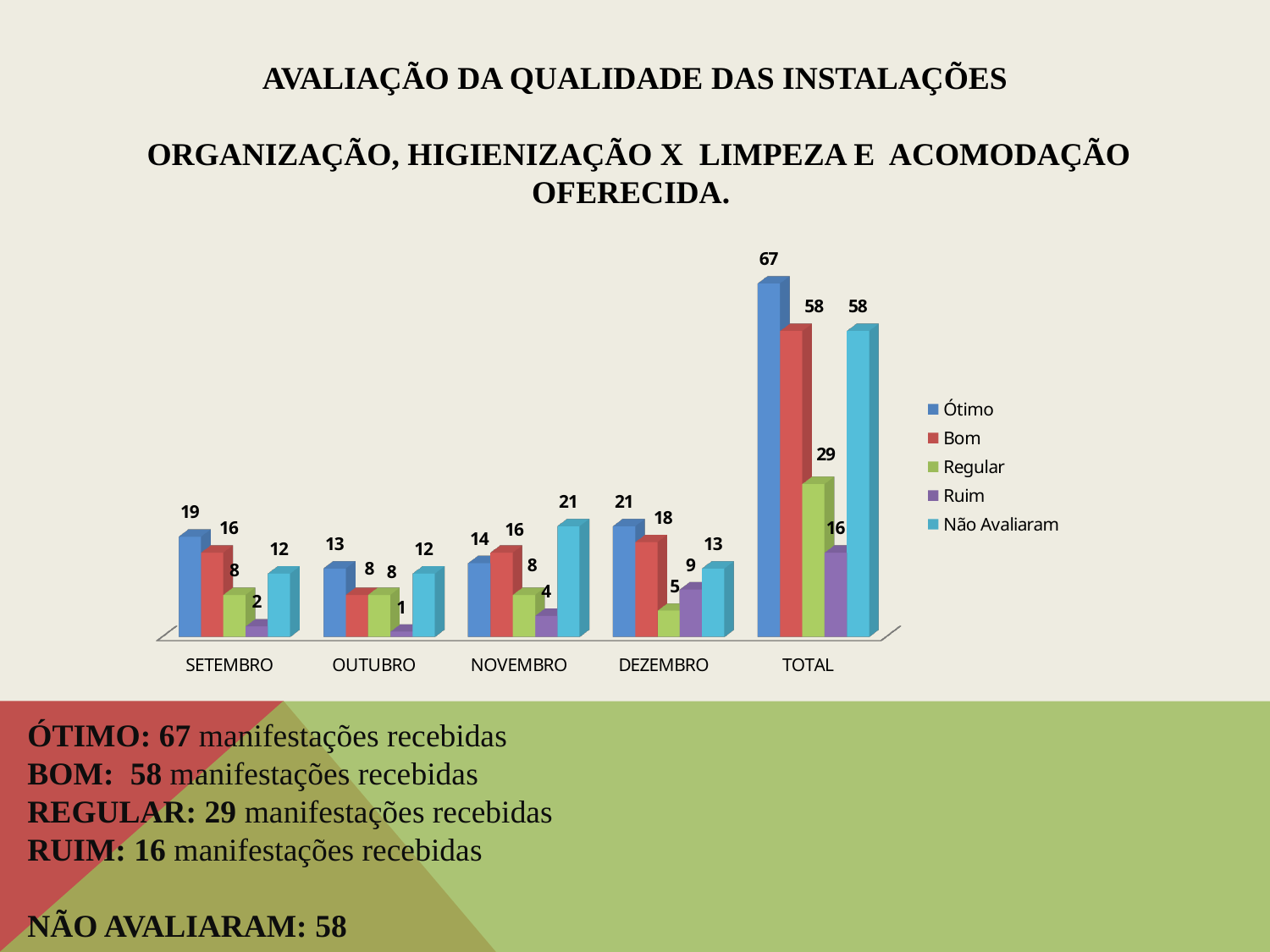
Which category has the highest value for Ótimo? TOTAL How many series does the legend list? 5 Which is larger in DEZEMBRO, Ótimo or Bom? Ótimo What is the value for Ruim in OUTUBRO? 1 What kind of chart is shown on the slide? Bar chart What is the value for Não Avaliaram in NOVEMBRO? 21 Excluding TOTAL, which month has the lowest value for Ruim? OUTUBRO Which series is shown in red in the legend? Bom What is the value for Regular in TOTAL? 29 What is the difference between Ótimo and Bom in TOTAL? 9 What is the value for Ótimo in SETEMBRO? 19 How many categories are shown on the x axis? 5